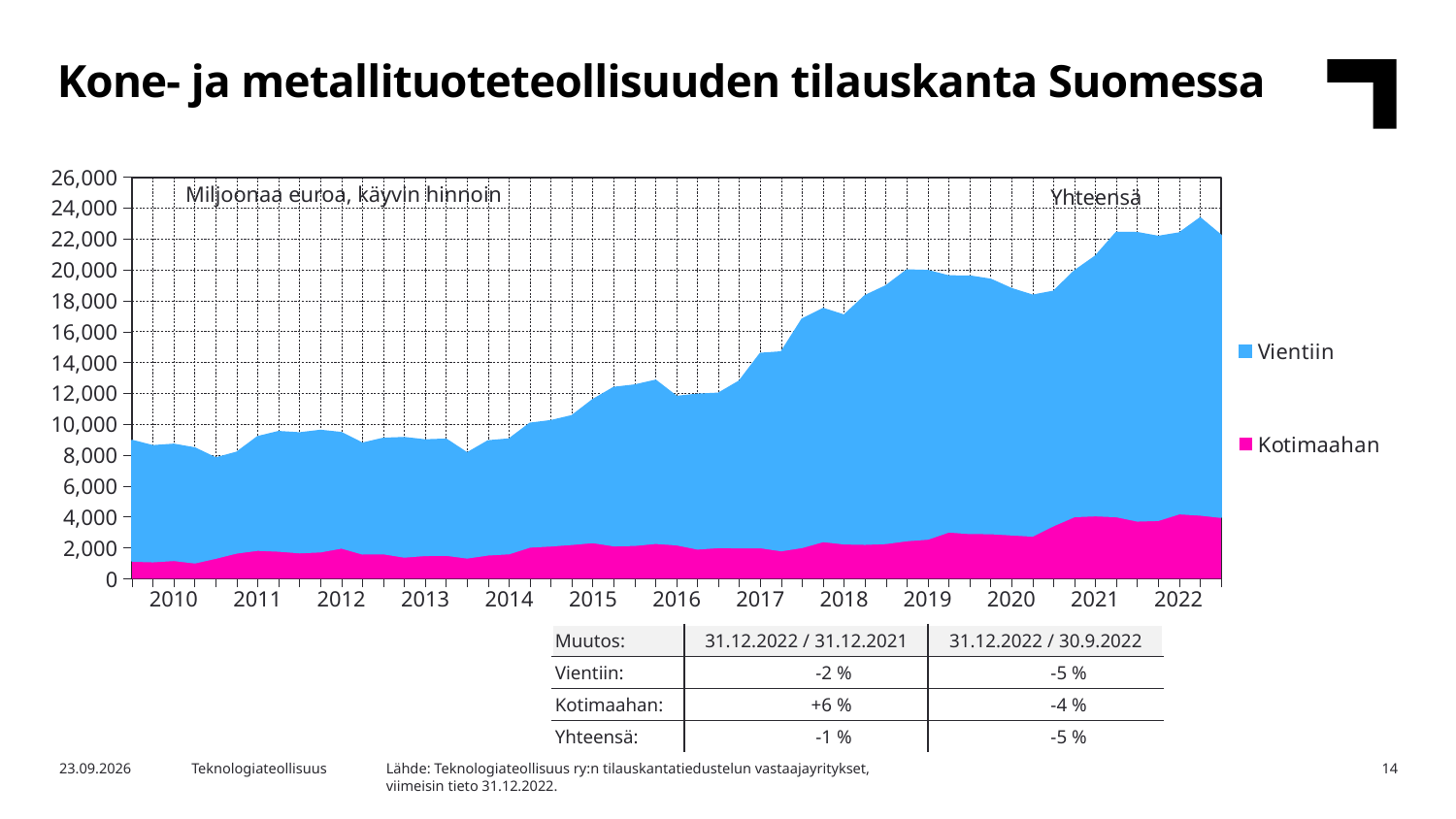
What unit is stated in the label inside the chart area? Miljoonaa euroa, käyvin hinnoin What are the two series named in the chart legend? Vientiin and Kotimaahan Is the Kotimaahan value in 2022 greater or less than 2,000? greater Is the total order backlog (Yhteensä) at the start of 2010 greater or less than 10,000? less Does the total order backlog (Yhteensä) generally rise or fall from 2010 to 2022? Rise Is the total order backlog (Yhteensä) in 2018 greater or less than 16,000? greater What kind of chart is shown on the slide? Area chart Which series is larger throughout the chart, Vientiin or Kotimaahan? Vientiin How many series does the chart legend list? 2 How many years are labelled on the x axis of the chart? 13